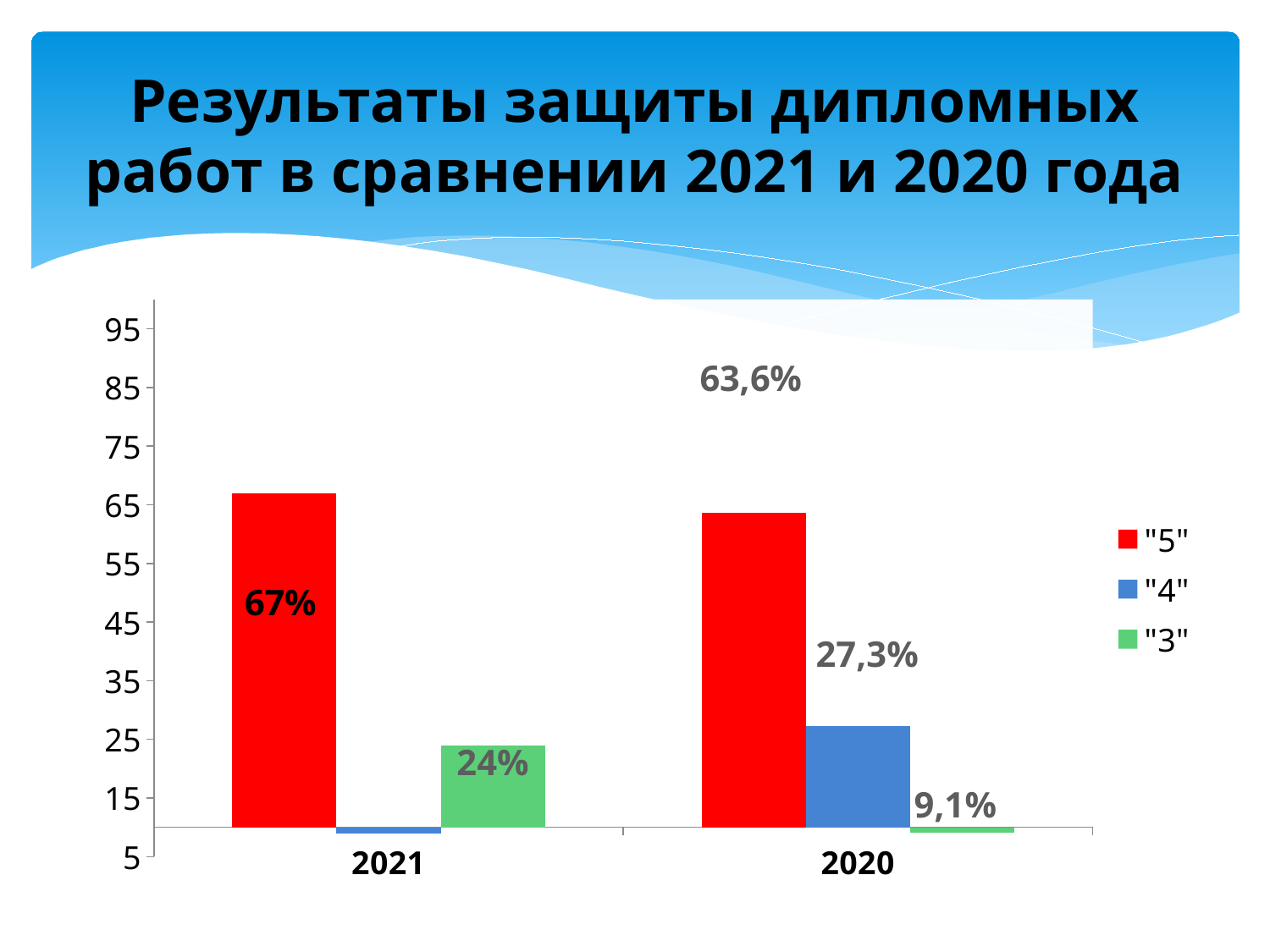
What kind of chart is shown on the slide? bar chart Is the value for "4" in 2021 greater or less than 15? less What is the value for "5" in 2020? 63,6% What is the value for "3" in 2020? 9,1% Which grade has the lowest value in 2020? "3" What is the value for "3" in 2021? 24% How many series does the legend list? 3 What is the value for "4" in 2020? 27,3% Which grade has the highest value in 2020? "5" What is the value for "5" in 2021? 67% What is the difference between the value for "4" and the value for "3" in 2020? 18,2% Is the value for "5" larger in 2021 or in 2020? 2021